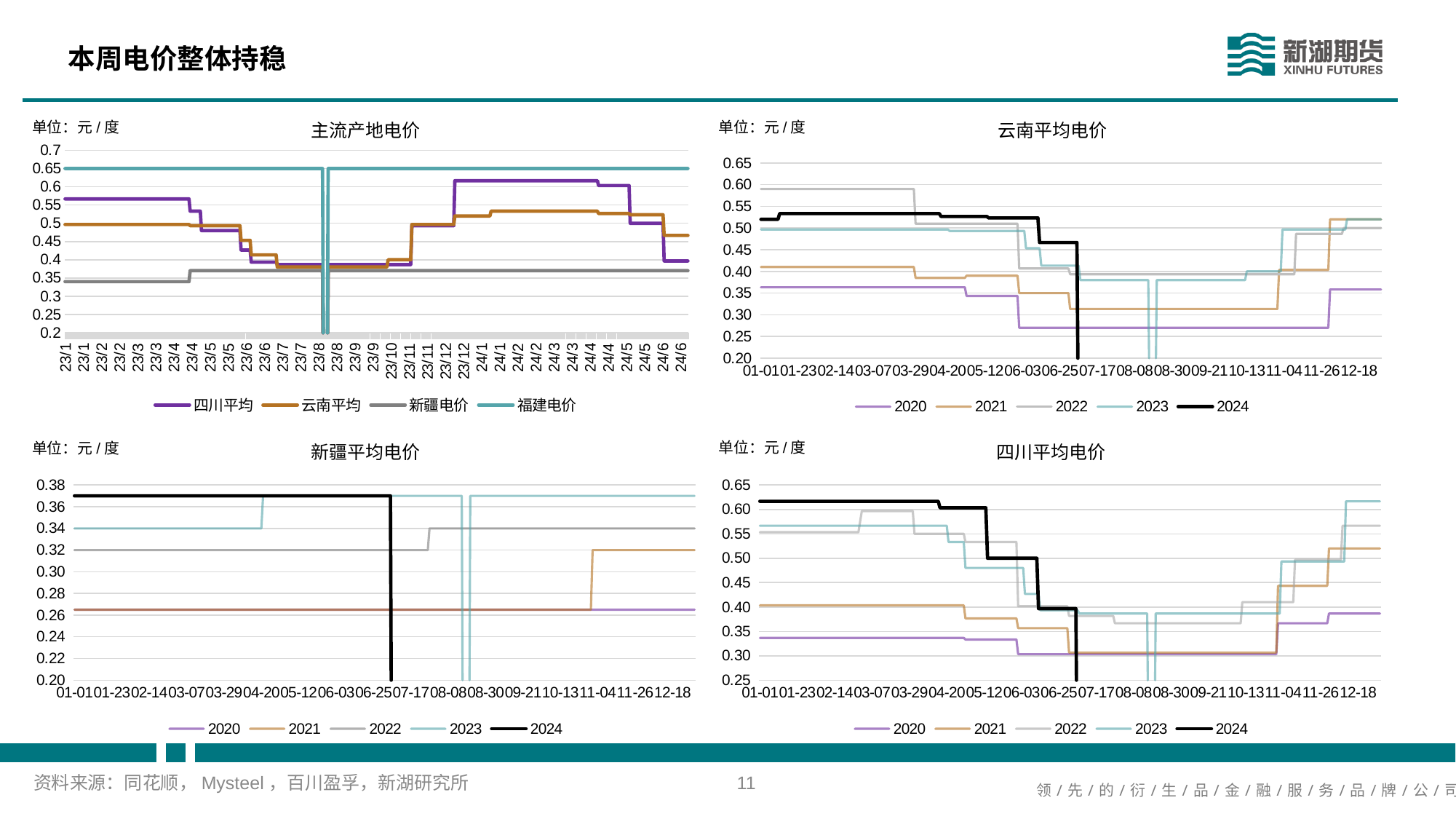
How many series does the legend of the 主流产地电价 chart list? 4 In the 主流产地电价 chart, does the 四川平均 line rise or fall from 23/1 to 23/7? fall In the 主流产地电价 chart, is the value of 四川平均 at 24/1 greater or less than 0.55? greater What kind of chart is the 主流产地电价 chart at the top left? line chart In the 主流产地电价 chart, which is larger at 23/1, 福建电价 or 新疆电价? 福建电价 In the 新疆平均电价 chart, is the 2020 line greater or less than 0.28? less How many series does the legend of the 云南平均电价 chart list? 5 In the 四川平均电价 chart, which is larger at 01-01, the 2024 line or the 2020 line? 2024 In the 四川平均电价 chart, is the 2024 line at 01-01 greater or less than 0.60? greater In the 主流产地电价 chart, what value does the 福建电价 line sit at throughout the period? 0.65 What unit is shown above each chart on the slide? 元/度